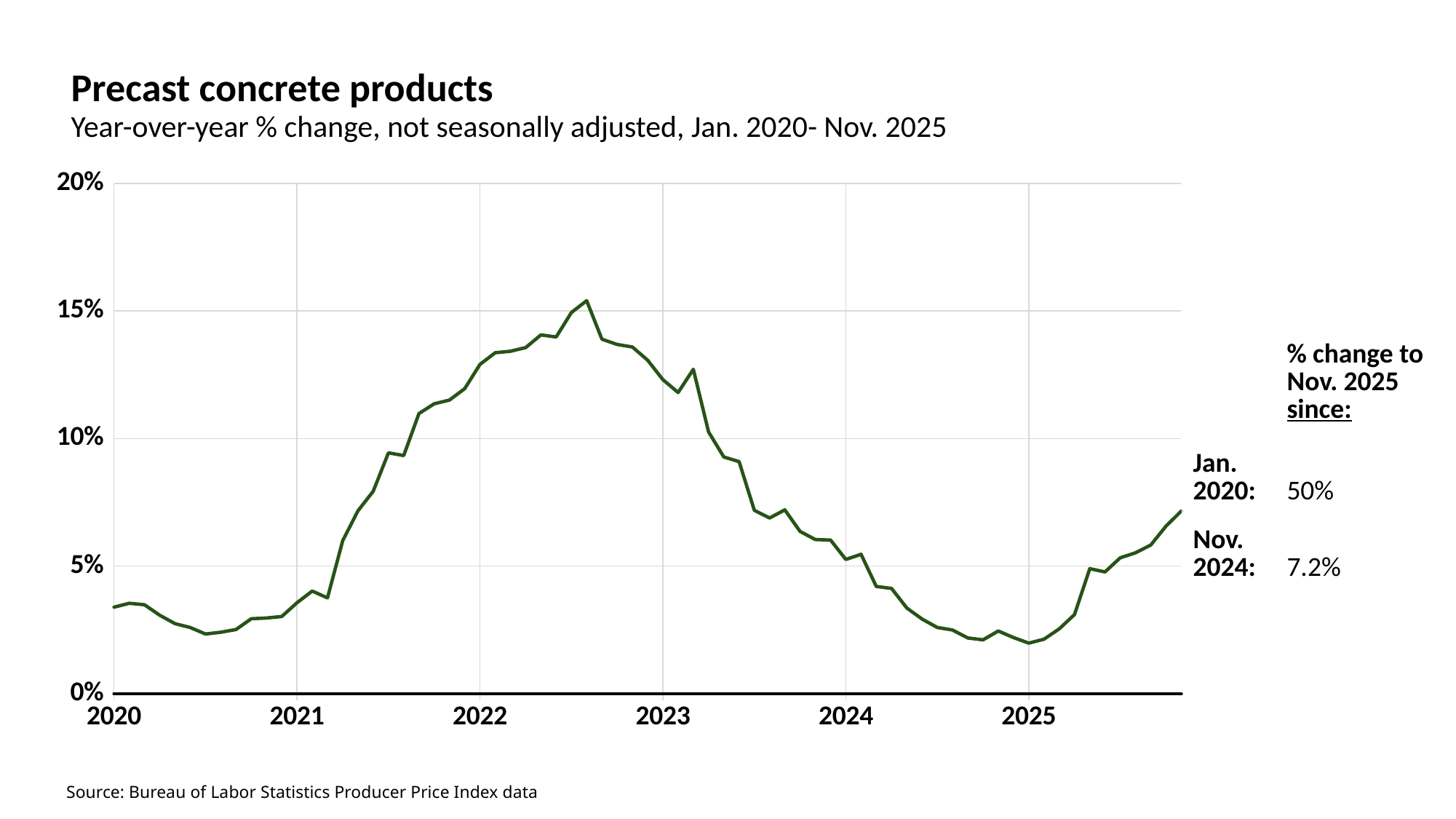
According to the annotation on the right, what is the % change to Nov. 2025 since Nov. 2024? 7.2% In which year does the line reach its highest value? 2022 Is the value at the start of 2023 greater or less than 10%? greater How many year labels are shown on the x axis? 6 What kind of chart is shown on the slide? line chart Does the line rise or fall between mid-2022 and the start of 2025? fall Is the peak value of the line in 2022 greater or less than 15%? greater What is the title of the chart? Precast concrete products Is the value at the start of 2025 greater or less than 5%? less Which is larger, the value at the start of 2022 or the value at the start of 2020? start of 2022 How many lines are plotted on the chart? 1